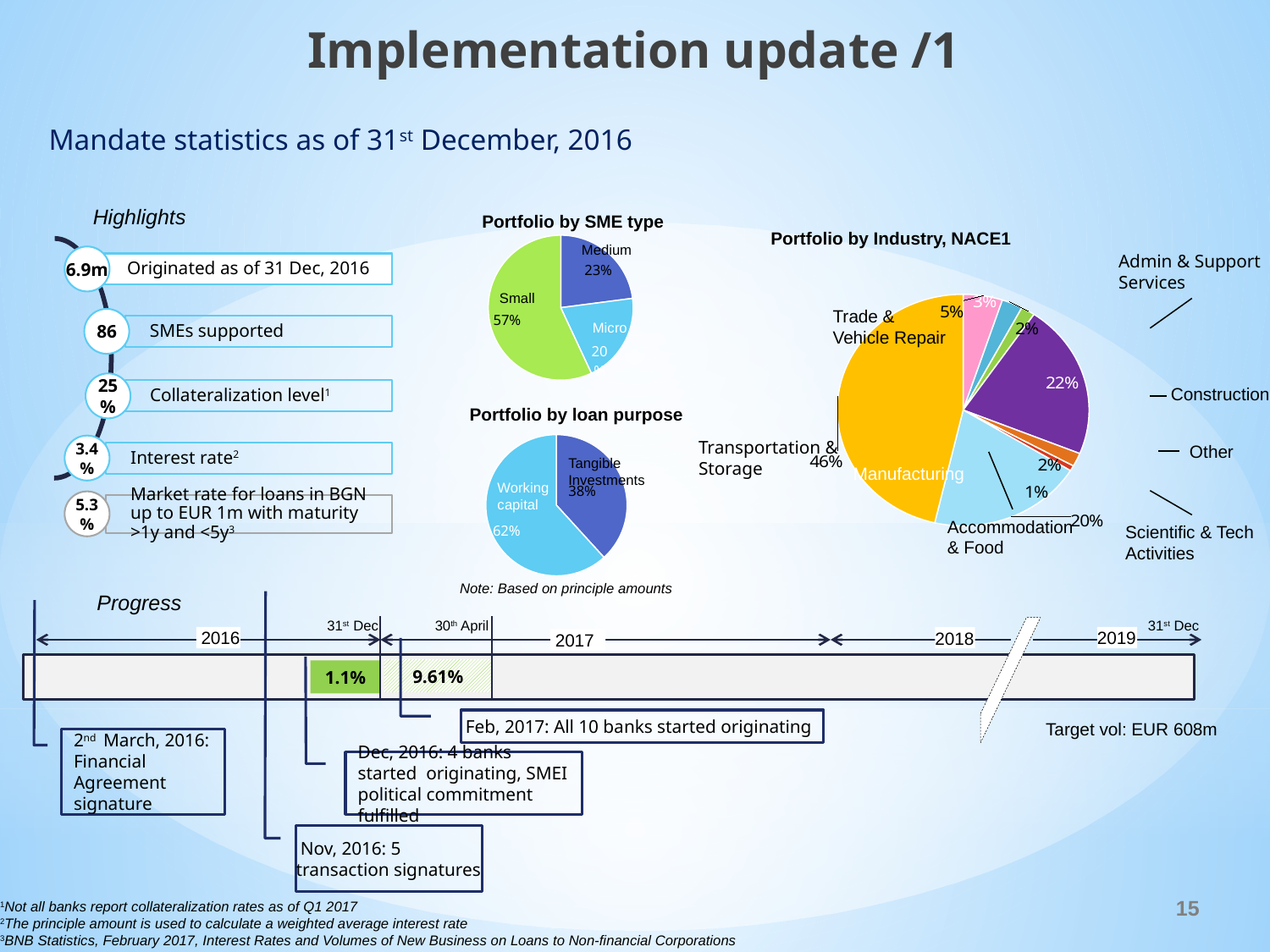
In the 'Portfolio by loan purpose' chart, what share is Tangible Investments? 38% In the 'Portfolio by loan purpose' chart, how many percentage points larger is Working capital than Tangible Investments? 24% How many slices does the 'Portfolio by SME type' chart have? 3 In the 'Portfolio by SME type' chart, which SME type has the largest share? Small In the 'Portfolio by SME type' chart, what share of the portfolio is Micro? 20% What kind of chart is 'Portfolio by loan purpose'? Pie chart In the 'Portfolio by SME type' chart, which SME type has the smallest share? Micro In the 'Portfolio by SME type' chart, what share of the portfolio is Medium? 23% In the 'Portfolio by loan purpose' chart, what share is Working capital? 62% In the 'Portfolio by Industry, NACE1' chart, what is the share of the largest slice? 46% In the 'Portfolio by SME type' chart, what share of the portfolio is Small? 57%